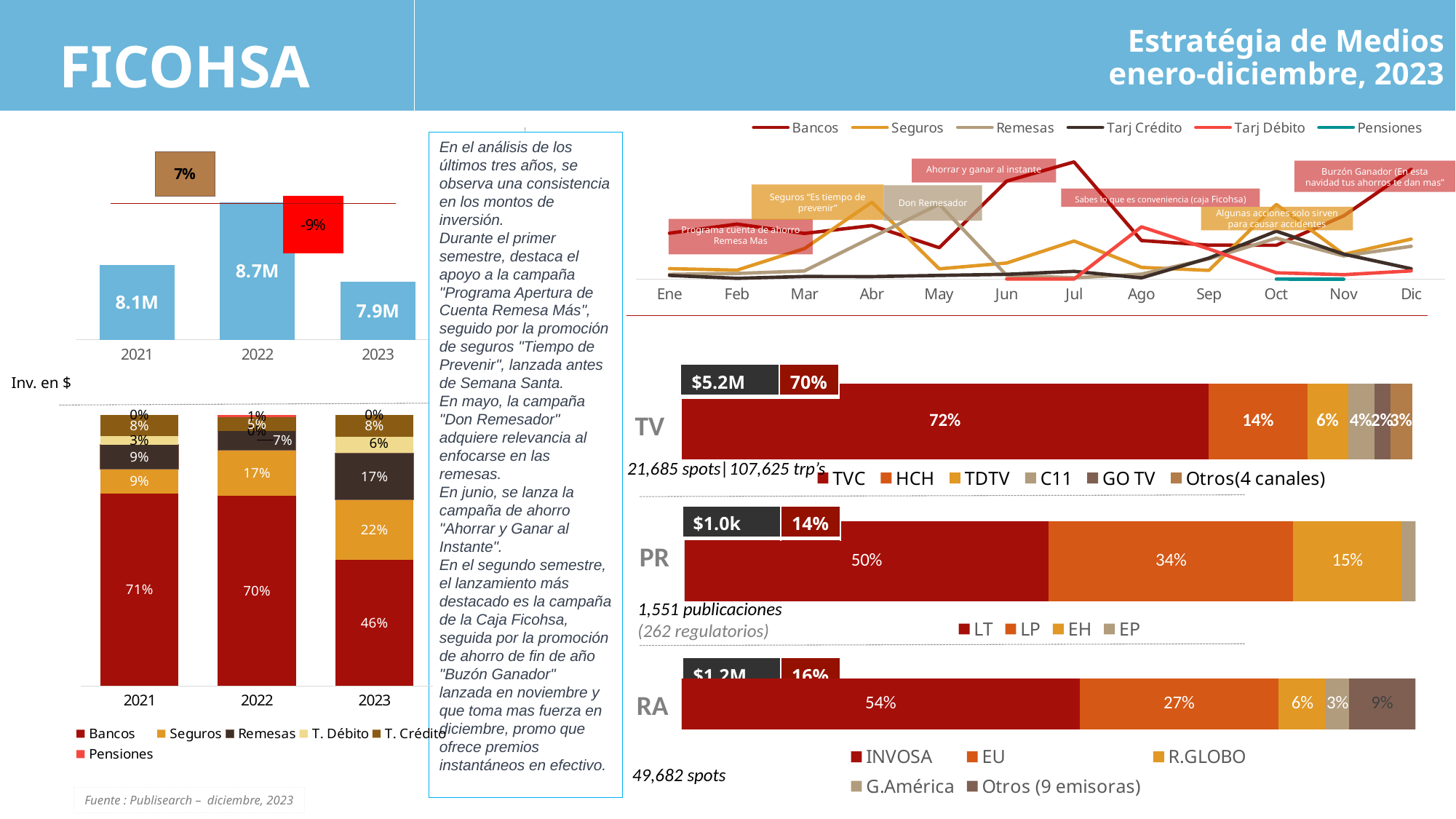
In the TV bar, what share does HCH have? 14% In the bottom-left stacked bar chart, what share does Bancos have in 2023? 46% In the PR bar, which channel has the largest share? LT What kind of chart is the top-right chart showing Bancos, Seguros, Remesas and other series by month? Line chart In the RA bar, which is larger, EU or R.GLOBO? EU In the top-left investment bar chart, which year has the lowest investment? 2023 In the top-left investment bar chart, what is the value for 2022? 8.7M In the top-left investment bar chart, what percentage change is shown above the 2023 bar? -9% How many series does the legend of the bottom-left stacked bar chart list? 6 In the bottom-left stacked bar chart, what is the difference between the Seguros share in 2023 and in 2021? 13% How many spots are reported below the RA bar? 49,682 spots In the top-right line chart, how many months are shown on the x axis? 12